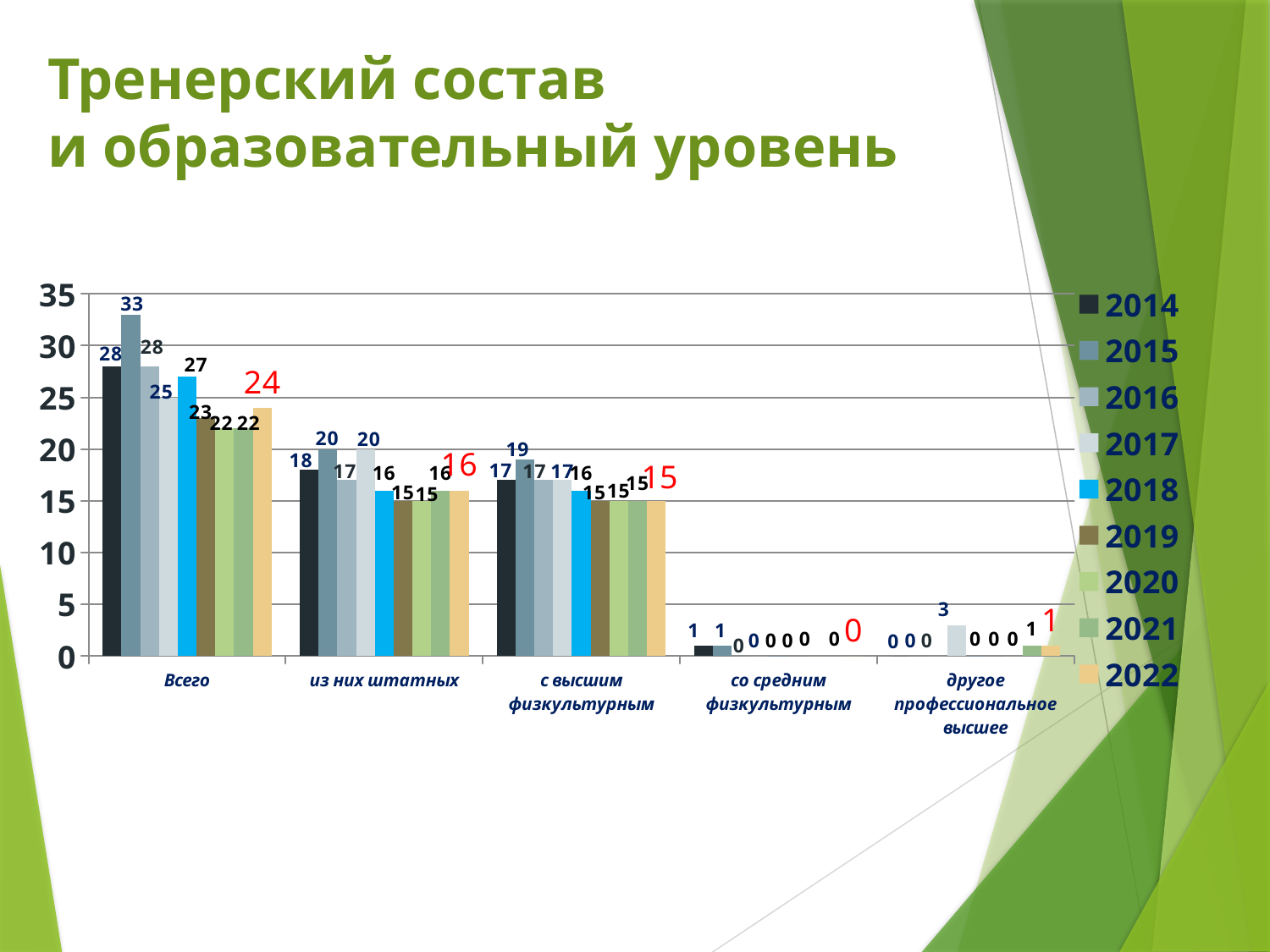
What is the value for 2017 in the "другое профессиональное высшее" category? 3 Which is larger in the "из них штатных" category: the value for 2014 or the value for 2015? 2015 How many series does the legend list? 9 What is the value for 2018 in the "из них штатных" category? 16 What kind of chart is shown on the slide? bar chart What is the difference between the 2015 and 2014 values in the "Всего" category? 5 How many categories are shown on the x axis? 5 What is the value for 2022 in the "Всего" category? 24 Which year has the highest value in the "Всего" category? 2015 What is the title of the slide? Тренерский состав и образовательный уровень What is the value for 2015 in the "Всего" category? 33 Which year has the highest value in the "с высшим физкультурным" category? 2015